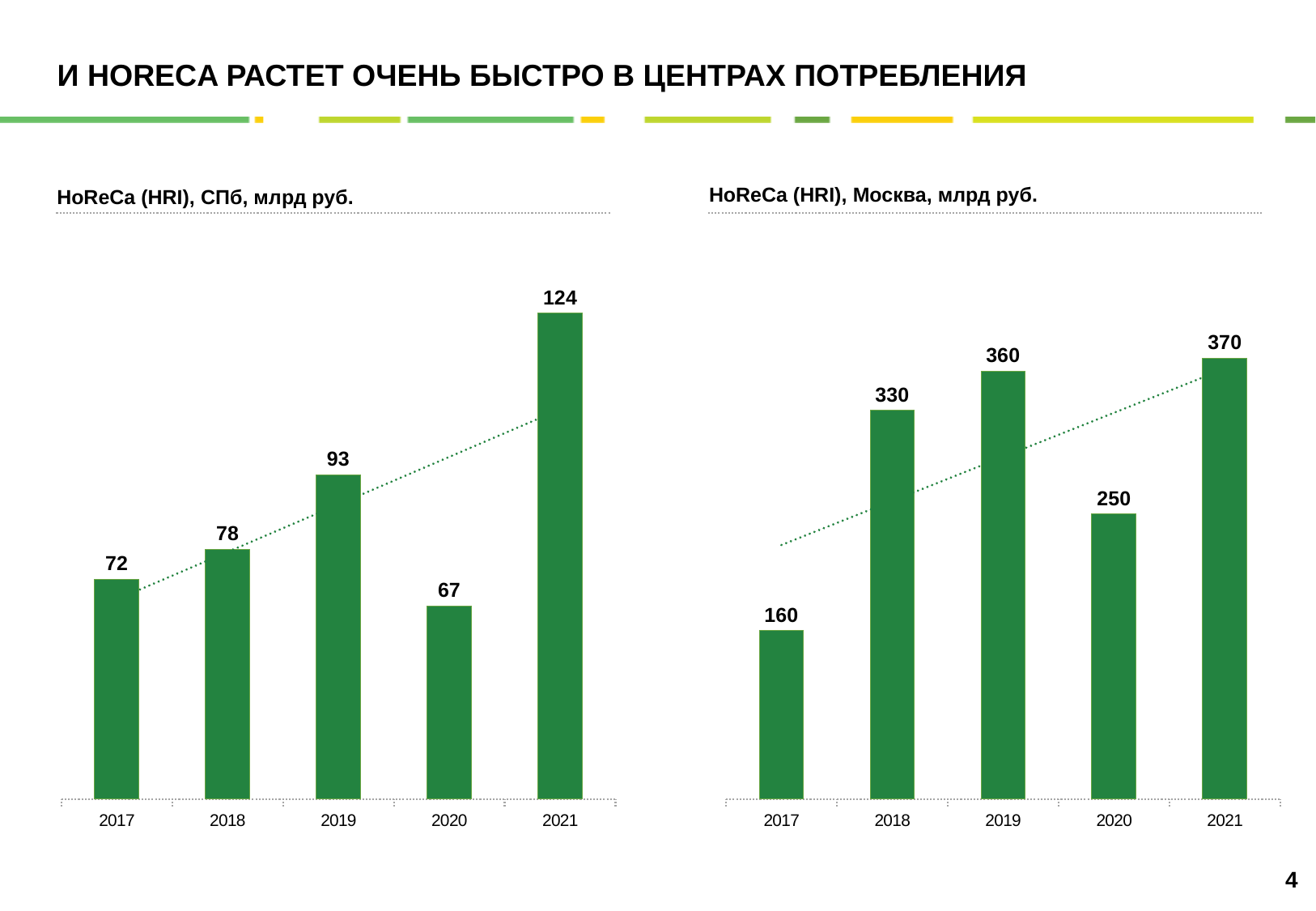
In the chart 'HoReCa (HRI), СПб, млрд руб.', which year has the highest value? 2021 In the chart 'HoReCa (HRI), Москва, млрд руб.', which is larger, the value for 2017 or the value for 2020? 2020 What is the title of the chart on the right side of the slide? HoReCa (HRI), Москва, млрд руб. In the chart 'HoReCa (HRI), СПб, млрд руб.', what is the difference between the 2021 and 2020 values? 57 In the chart 'HoReCa (HRI), СПб, млрд руб.', what is the value for 2019? 93 In the chart 'HoReCa (HRI), Москва, млрд руб.', which year has the lowest value? 2017 What kind of chart is 'HoReCa (HRI), СПб, млрд руб.'? Bar chart In the chart 'HoReCa (HRI), Москва, млрд руб.', what is the value for 2020? 250 In the chart 'HoReCa (HRI), СПб, млрд руб.', which is larger, the value for 2018 or the value for 2020? 2018 In the chart 'HoReCa (HRI), СПб, млрд руб.', does the value rise or fall from 2019 to 2020? Fall How many years are shown in the chart 'HoReCa (HRI), Москва, млрд руб.'? 5 In the chart 'HoReCa (HRI), Москва, млрд руб.', what is the difference between the 2019 and 2018 values? 30